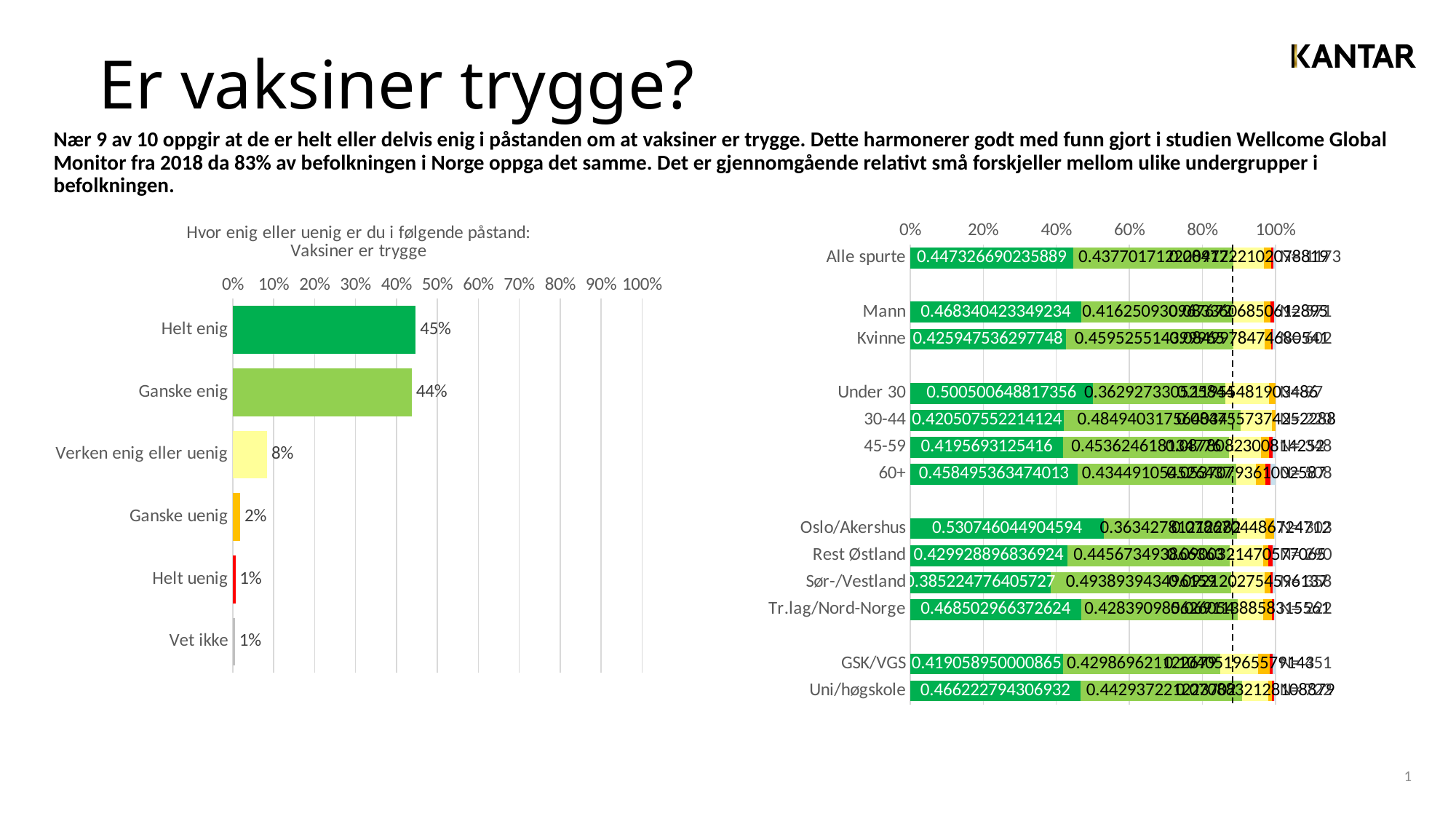
In the left chart 'Vaksiner er trygge', how many categories are shown? 6 What kind of chart is the left chart 'Vaksiner er trygge'? Bar chart In the left chart 'Vaksiner er trygge', which category has the highest value? Helt enig In the left chart 'Vaksiner er trygge', which is larger, 'Ganske enig' or 'Verken enig eller uenig'? Ganske enig In the left chart 'Vaksiner er trygge', what is the value for 'Helt enig'? 45% In the left chart 'Vaksiner er trygge', what is the value for 'Ganske uenig'? 2% In the left chart 'Vaksiner er trygge', what is the value for 'Ganske enig'? 44% In the right chart, how many subgroup categories are listed on the vertical axis? 13 In the right chart, what is the value of the first (dark green) segment for 'Alle spurte'? 0.447326690235889 In the left chart 'Vaksiner er trygge', what is the difference between 'Helt enig' and 'Verken enig eller uenig'? 37% In the left chart 'Vaksiner er trygge', what is the value for 'Verken enig eller uenig'? 8% In the right chart, which category has the largest first (dark green) segment? Oslo/Akershus